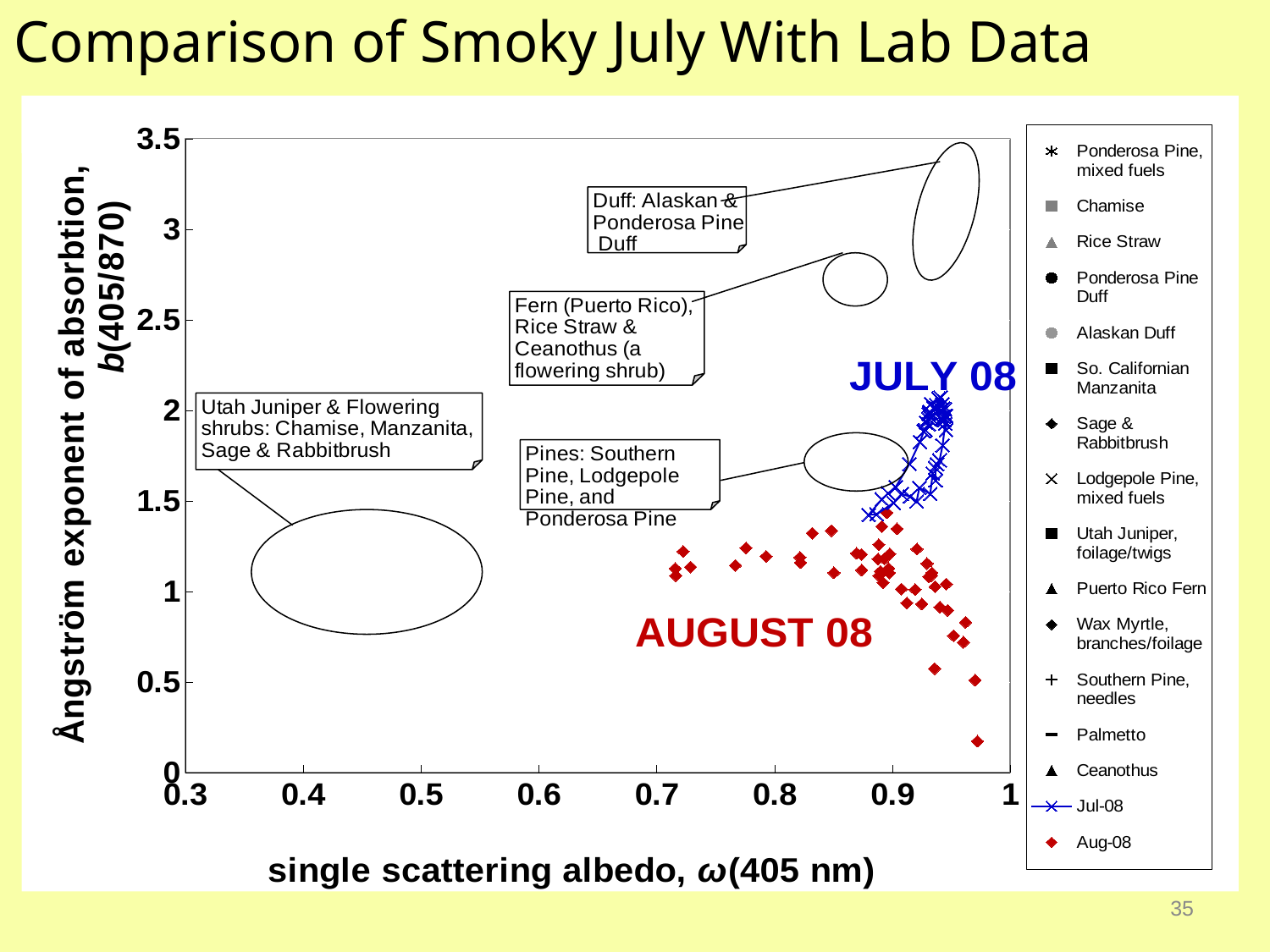
Is the Ångström exponent of the Utah Juniper & Flowering shrubs group greater or less than 1.5? less What is the title of the slide containing the chart? Comparison of Smoky July With Lab Data Which labelled lab-data group has the lowest single scattering albedo values on the chart? Utah Juniper & Flowering shrubs: Chamise, Manzanita, Sage & Rabbitbrush Are the Ångström exponent values of the Jul-08 points greater or less than 1? greater What colour are the Jul-08 data points? blue Are the single scattering albedo values of the Jul-08 points greater or less than 0.8? greater What kind of chart is shown on the slide? scatter plot Which labelled lab-data group has the highest Ångström exponent values on the chart? Duff: Alaskan & Ponderosa Pine Duff How many entries does the legend list? 16 Which series has higher Ångström exponent values overall, Jul-08 or Aug-08? Jul-08